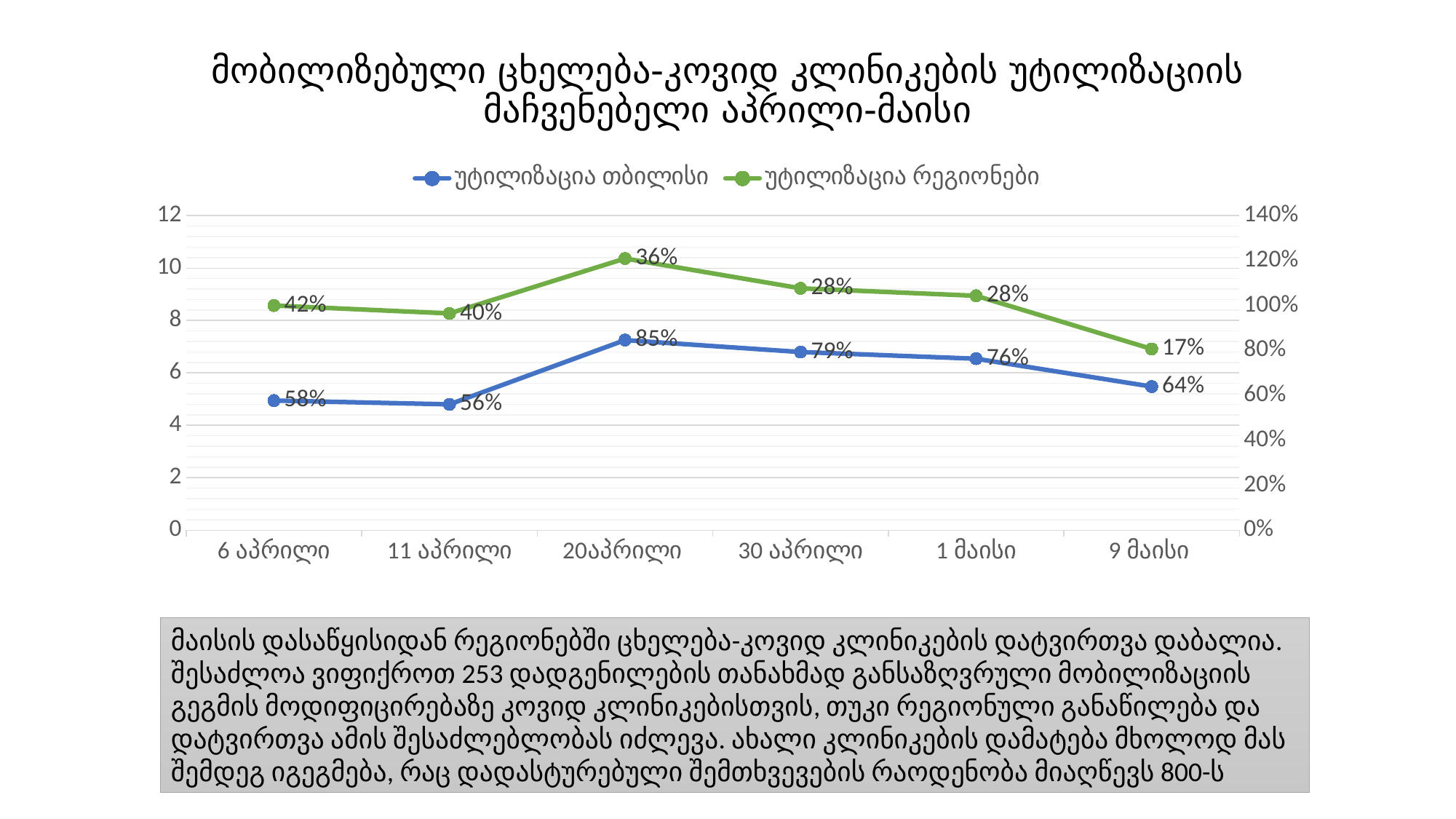
What is the value for უტილიზაცია თბილისი on 6 აპრილი? 58% Does უტილიზაცია რეგიონები rise or fall from 20აპრილი to 9 მაისი? fall Which colour is used for the უტილიზაცია რეგიონები line? green How many series does the legend list? 2 What is the difference between the უტილიზაცია თბილისი values on 20აპრილი and 9 მაისი? 21% What is the value for უტილიზაცია რეგიონები on 9 მაისი? 17% How many dates are shown on the x axis? 6 On which date is უტილიზაცია თბილისი highest? 20აპრილი What is the value for უტილიზაცია თბილისი on 20აპრილი? 85% What type of chart is shown on the slide? line chart What is the value for უტილიზაცია რეგიონები on 30 აპრილი? 28% On which date is უტილიზაცია რეგიონები lowest? 9 მაისი